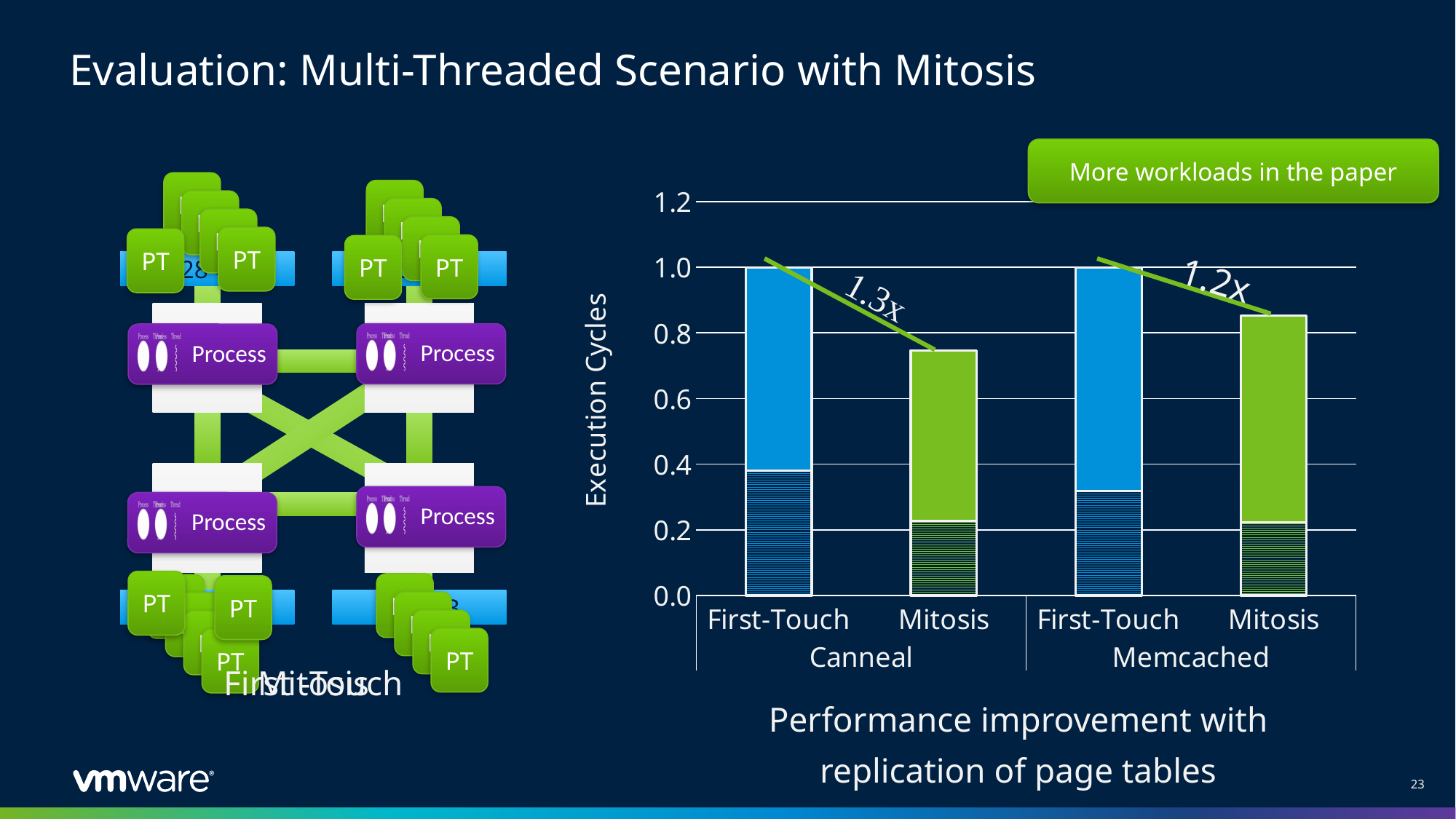
Is the Execution Cycles value for Mitosis under Canneal greater or less than 0.8? less Which has the larger Execution Cycles value: Mitosis under Canneal or Mitosis under Memcached? Mitosis under Memcached What kind of chart is shown on the slide? Bar chart What speedup is annotated for Canneal between First-Touch and Mitosis? 1.3x How many workloads are shown on the x axis of the chart? 2 What is the label of the y axis of the chart? Execution Cycles What is the Execution Cycles value for First-Touch under Canneal? 1.0 What is the Execution Cycles value for First-Touch under Memcached? 1.0 How many bars are plotted in the chart? 4 Is the Execution Cycles value for Mitosis under Memcached greater or less than 1.0? less Is the Execution Cycles value for Mitosis under Memcached greater or less than 0.8? greater Which bar has the lowest Execution Cycles value? Mitosis under Canneal